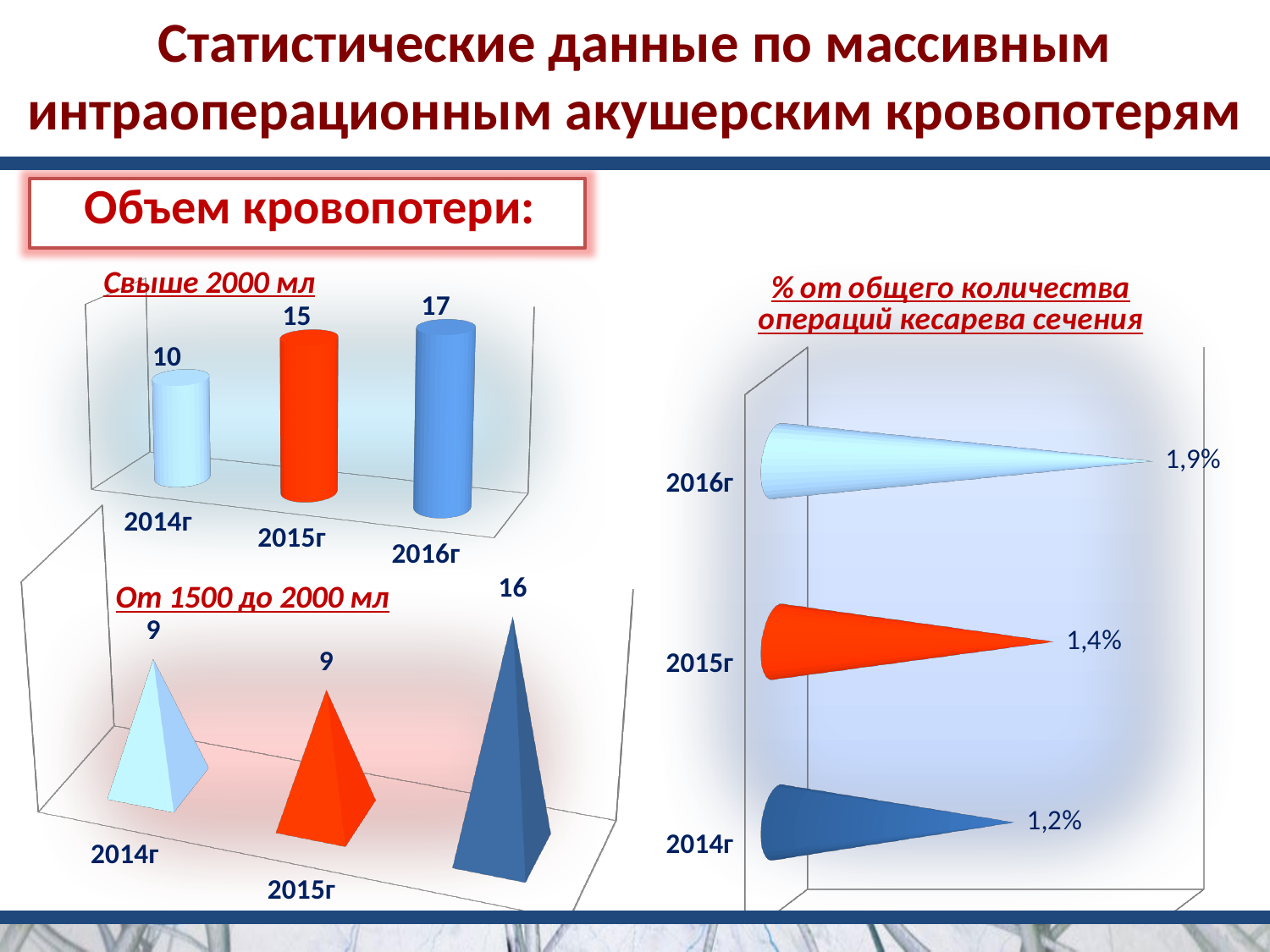
In the chart titled '% от общего количества операций кесарева сечения', which is larger, the value for 2016г or 2015г? 2016г In the chart titled 'От 1500 до 2000 мл', what is the highest value shown? 16 In the chart titled '% от общего количества операций кесарева сечения', what is the value for 2015г? 1,4% In the chart titled '% от общего количества операций кесарева сечения', which year has the lowest value? 2014г In the chart titled 'Свыше 2000 мл', what is the difference between the values for 2016г and 2014г? 7 In the chart titled 'Свыше 2000 мл', do the values rise or fall from 2014г to 2016г? rise In the chart titled 'Свыше 2000 мл', what is the value for 2014г? 10 In the chart titled 'Свыше 2000 мл', which year has the highest value? 2016г In the chart titled 'От 1500 до 2000 мл', how many data points are plotted? 3 In the chart titled 'Свыше 2000 мл', what is the value for 2015г? 15 What kind of chart is the one titled 'Свыше 2000 мл'? bar chart In the chart titled 'От 1500 до 2000 мл', what is the value for 2014г? 9